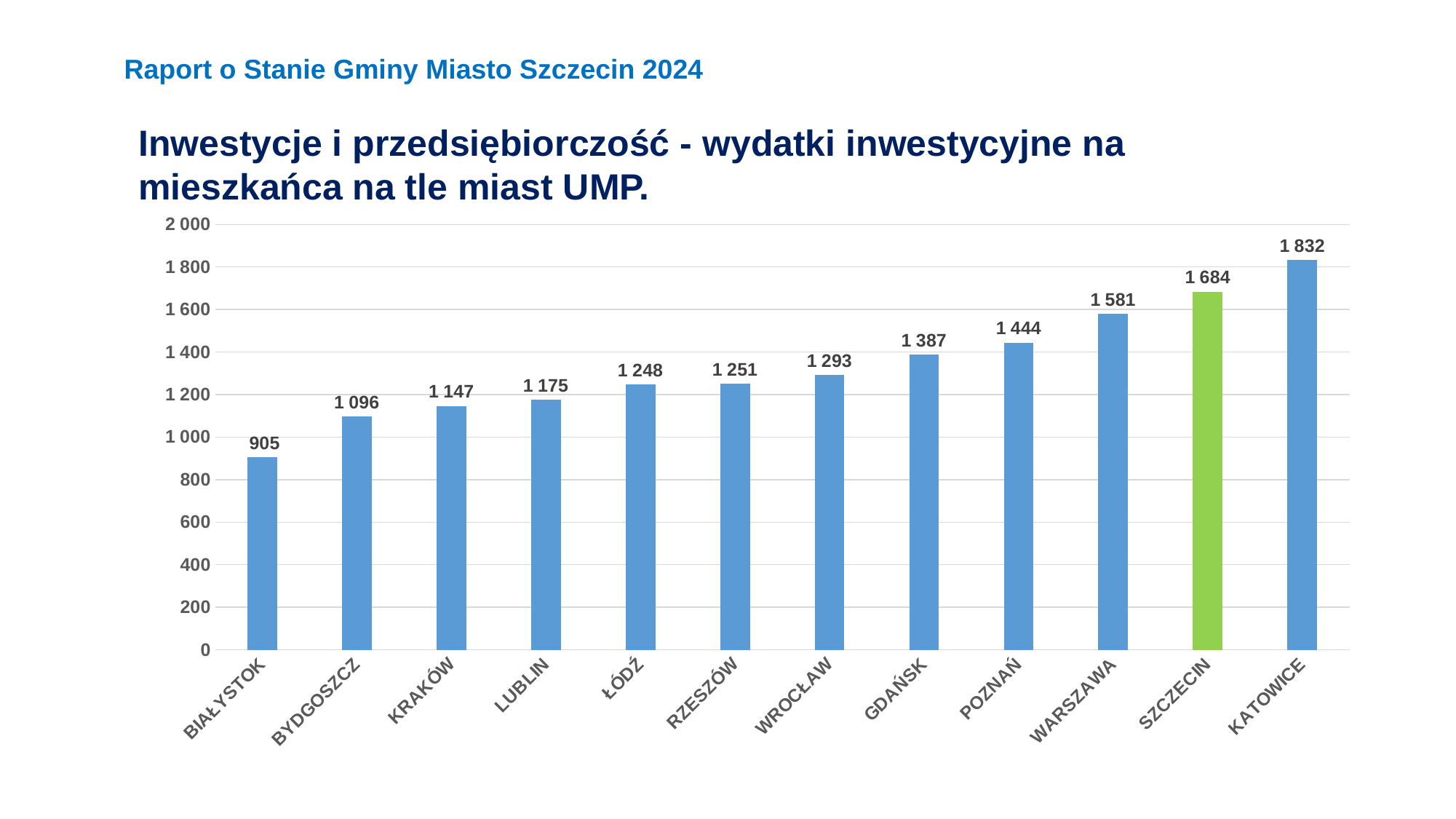
How many cities are shown on the chart? 12 Which city has the lowest value? BIAŁYSTOK What kind of chart is shown on the slide? bar chart Which city has the highest value? KATOWICE What is the difference between the values for KATOWICE and SZCZECIN? 148 Which has a larger value, WARSZAWA or POZNAŃ? WARSZAWA What is the value shown for WROCŁAW? 1 293 Is the value for GDAŃSK greater or less than 1 200? greater Do the values rise or fall from left to right along the x axis? rise What is the value shown for BIAŁYSTOK? 905 What is the value shown for SZCZECIN? 1 684 Which city's bar is coloured green instead of blue? SZCZECIN